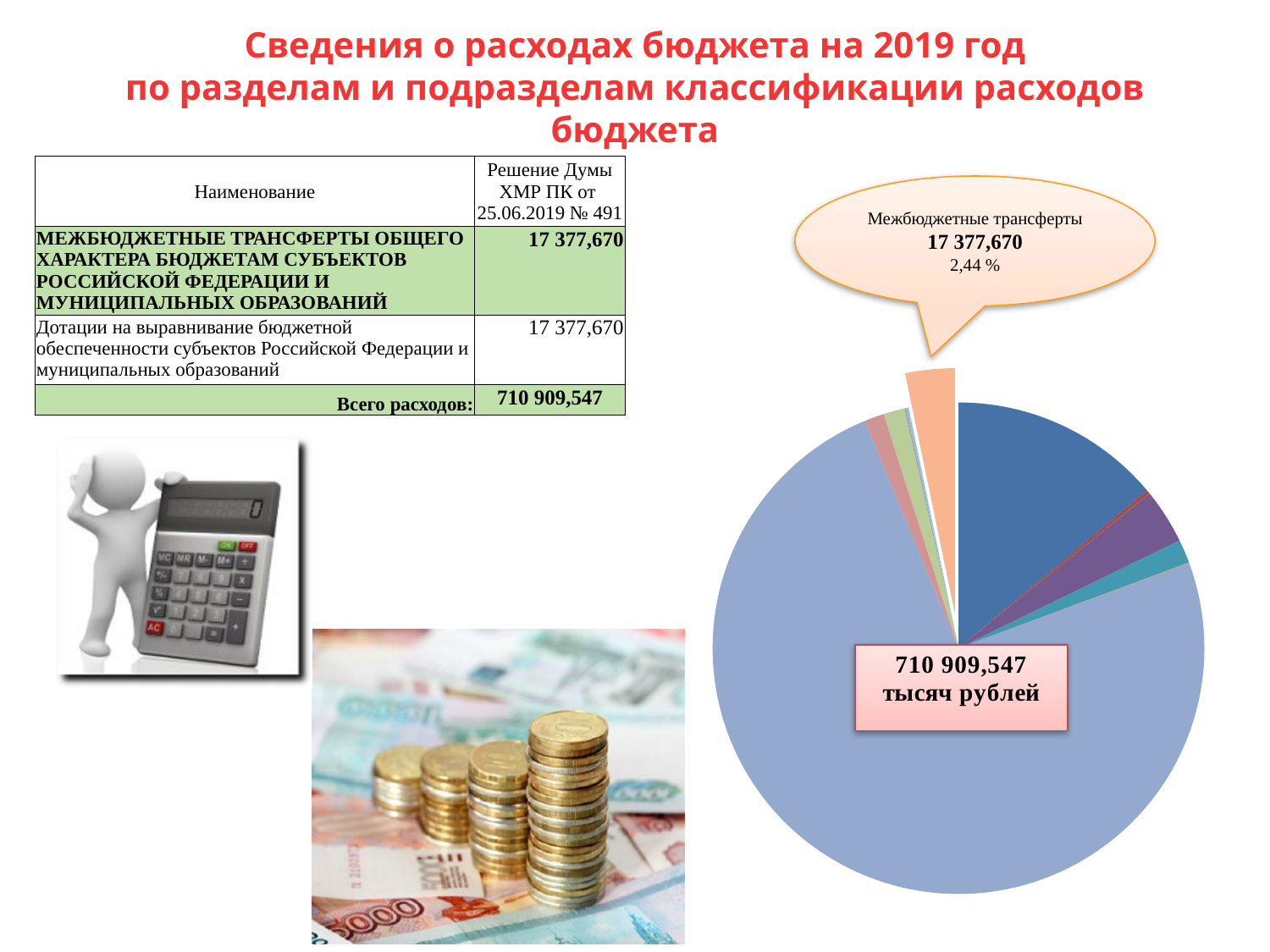
What share of the pie does the Межбюджетные трансферты slice represent, according to the callout? 2,44 % What kind of chart is shown on the slide? pie chart Which slice of the pie chart is pulled out from the rest and pointed to by the callout? Межбюджетные трансферты Is the Межбюджетные трансферты slice the largest slice of the pie chart? No Is the share of the Межбюджетные трансферты slice greater or less than 10%? less What value is shown in the callout for the Межбюджетные трансферты slice of the pie chart? 17 377,670 Does the pie chart have a legend listing its categories? No What total amount is shown in the label at the centre of the pie chart? 710 909,547 тысяч рублей